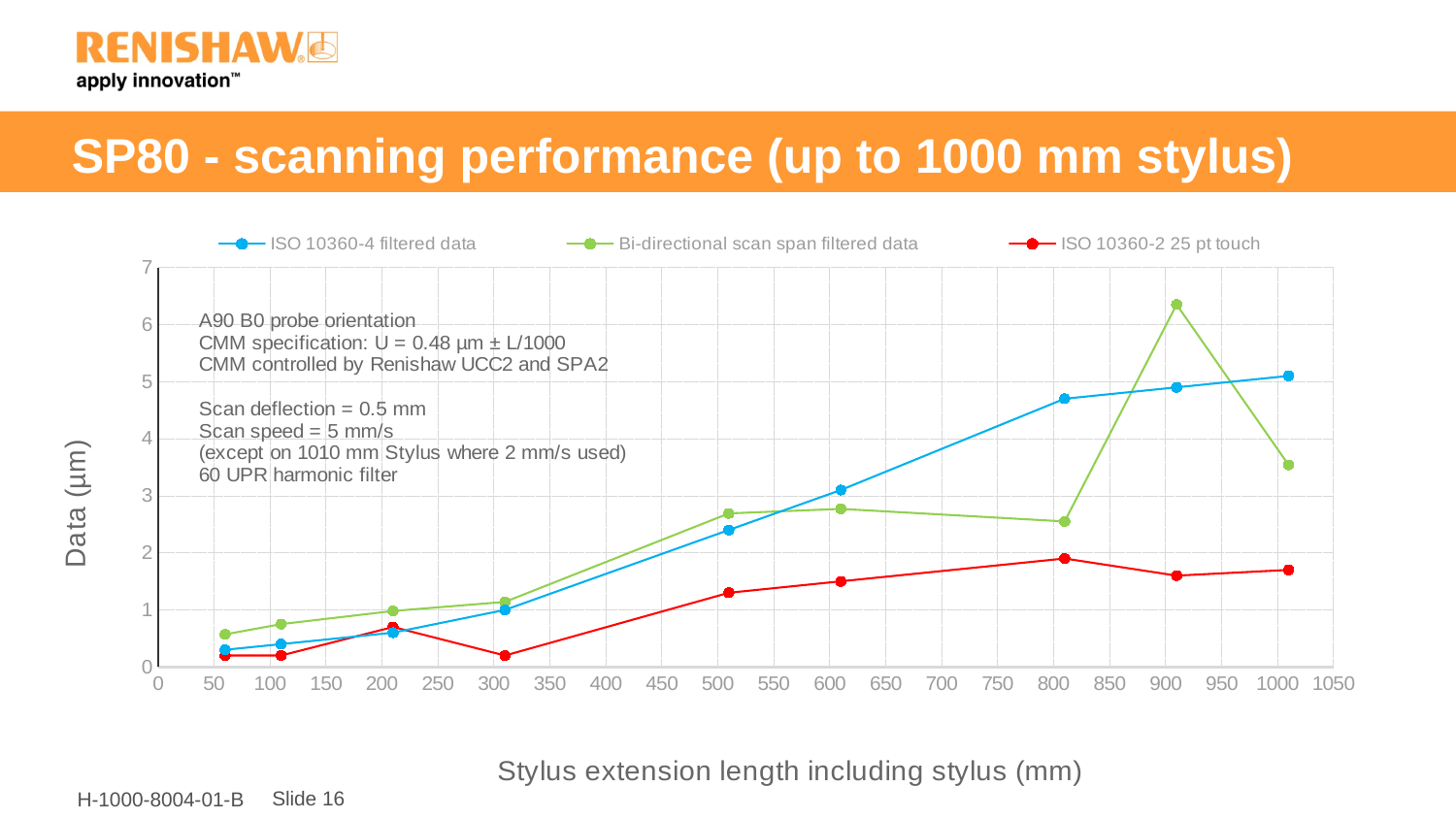
What kind of chart is shown on the slide? Line chart Is the value for Bi-directional scan span filtered data at a stylus extension length of about 910 mm greater or less than 6? greater Does the ISO 10360-4 filtered data series generally rise or fall as stylus extension length increases? Rise Is the value for ISO 10360-2 25 pt touch at a stylus extension length of about 310 mm greater or less than 1? less At a stylus extension length of about 1010 mm, which series has the larger value: ISO 10360-4 filtered data or Bi-directional scan span filtered data? ISO 10360-4 filtered data How many series does the legend list? 3 What is the label of the y axis of the chart? Data (µm) Is the value for ISO 10360-4 filtered data at a stylus extension length of about 810 mm greater or less than 4? greater How many data points are plotted for the ISO 10360-4 filtered data series? 9